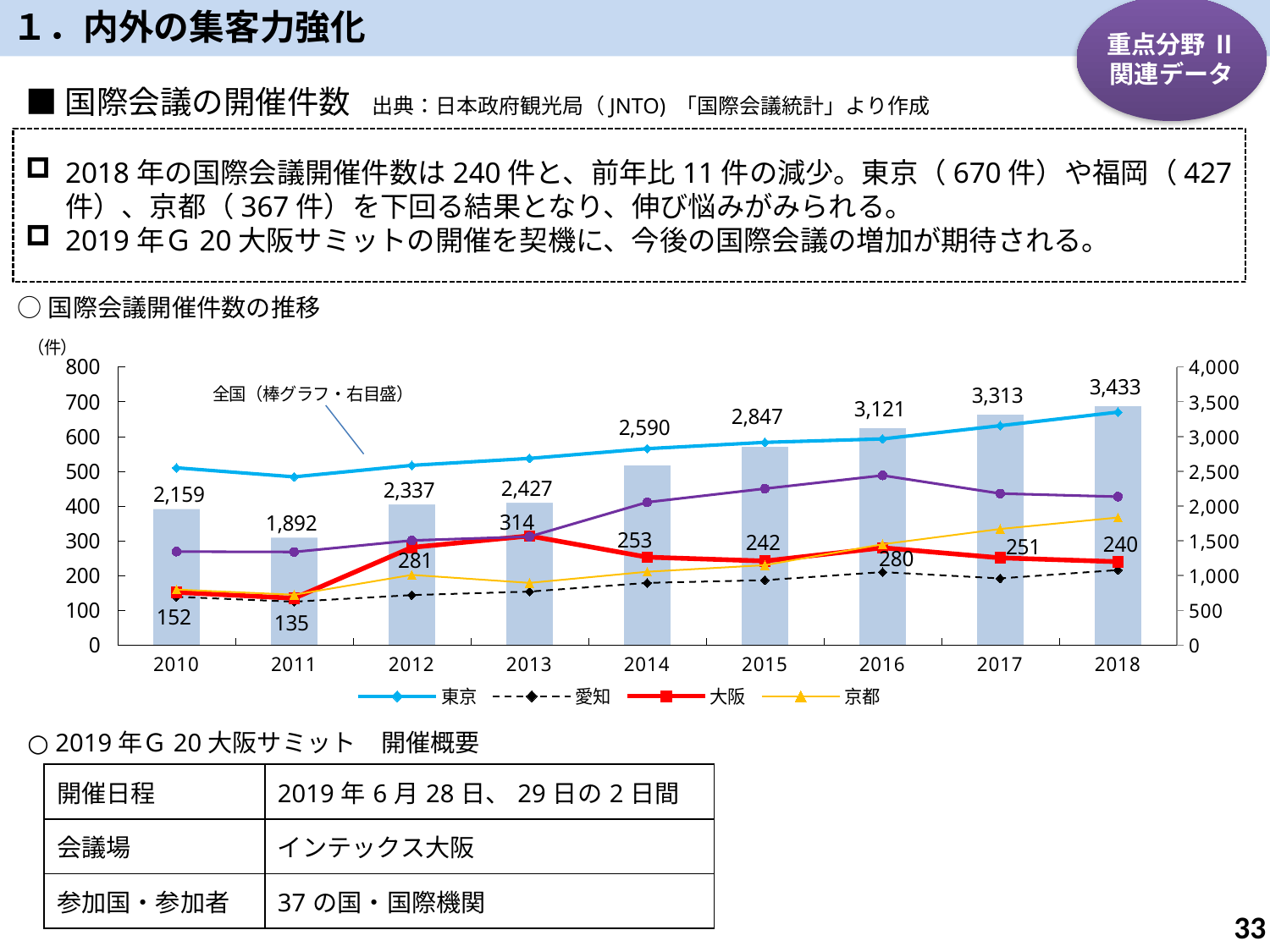
What is the value for 大阪 in 2018? 240 What kind of chart is this? Combination bar and line chart By how much did the 全国 value increase from 2017 to 2018? 120 Is the value for 東京 in 2018 greater or less than 600? greater What is the difference between the 大阪 values in 2013 and 2018? 74 Which is larger for 大阪: the value in 2012 or the value in 2014? 2012 In which year does the 大阪 line reach its highest value? 2013 What is the value of the 全国 bar in 2010? 2,159 How many years are shown on the x axis? 9 How many series does the legend list? 4 In which year is the 全国 bar highest? 2018 In which year is the 全国 bar lowest? 2011